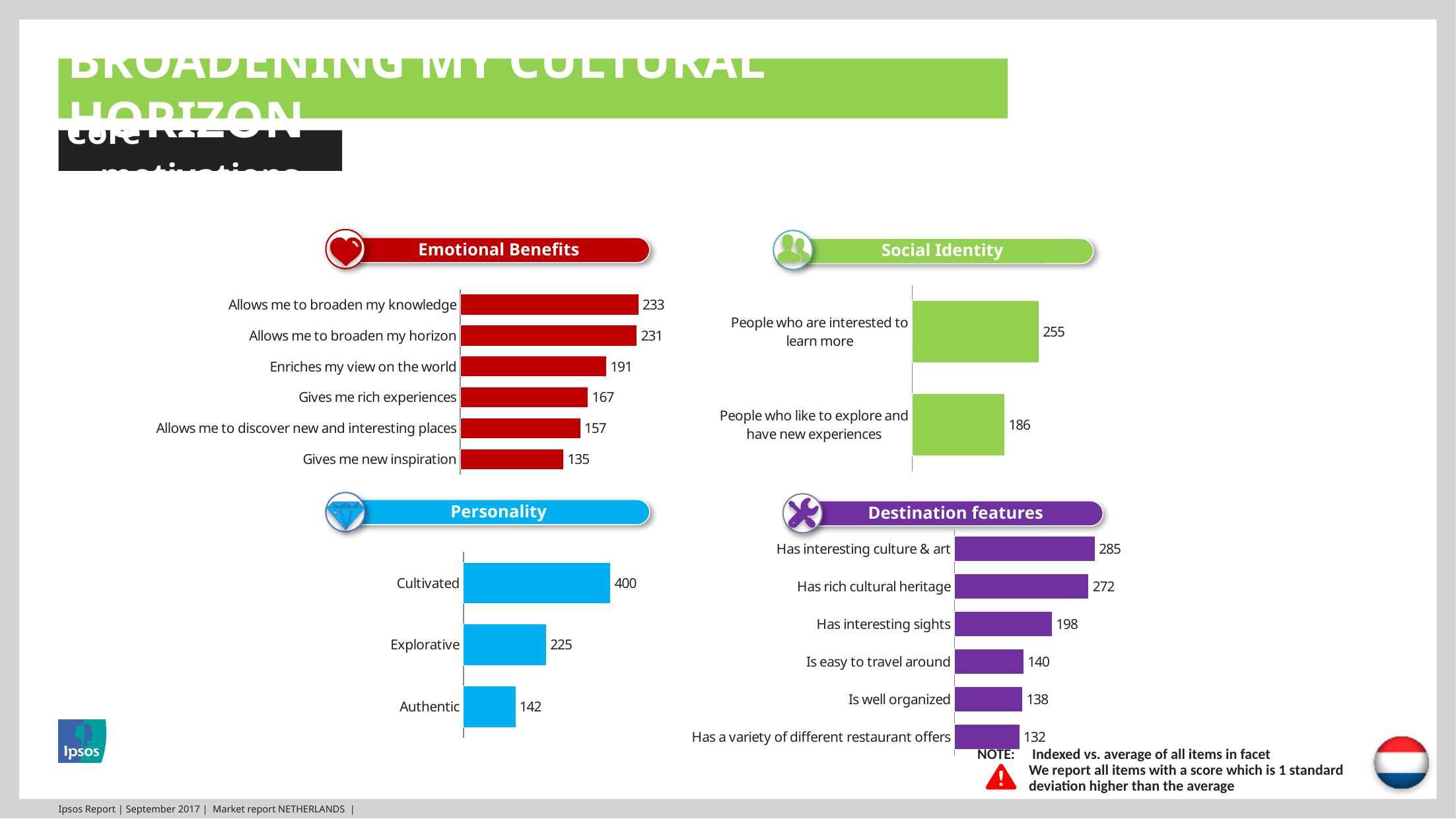
In the Destination features chart, what is the value for "Has interesting sights"? 198 What type of chart is the Personality chart? Bar chart In the Personality chart, what is the value for "Cultivated"? 400 In the Personality chart, what is the difference between "Explorative" and "Authentic"? 83 In the Destination features chart, which category has the highest value? Has interesting culture & art In the Emotional Benefits chart, what is the difference between "Allows me to broaden my knowledge" and "Gives me rich experiences"? 66 How many categories are shown in the Emotional Benefits chart? 6 In the Emotional Benefits chart, which category has the lowest value? Gives me new inspiration In the Emotional Benefits chart, what is the value for "Enriches my view on the world"? 191 In the Social Identity chart, which category has the higher value? People who are interested to learn more In the Destination features chart, which is larger: "Is easy to travel around" or "Is well organized"? Is easy to travel around In the Social Identity chart, what is the value for "People who like to explore and have new experiences"? 186